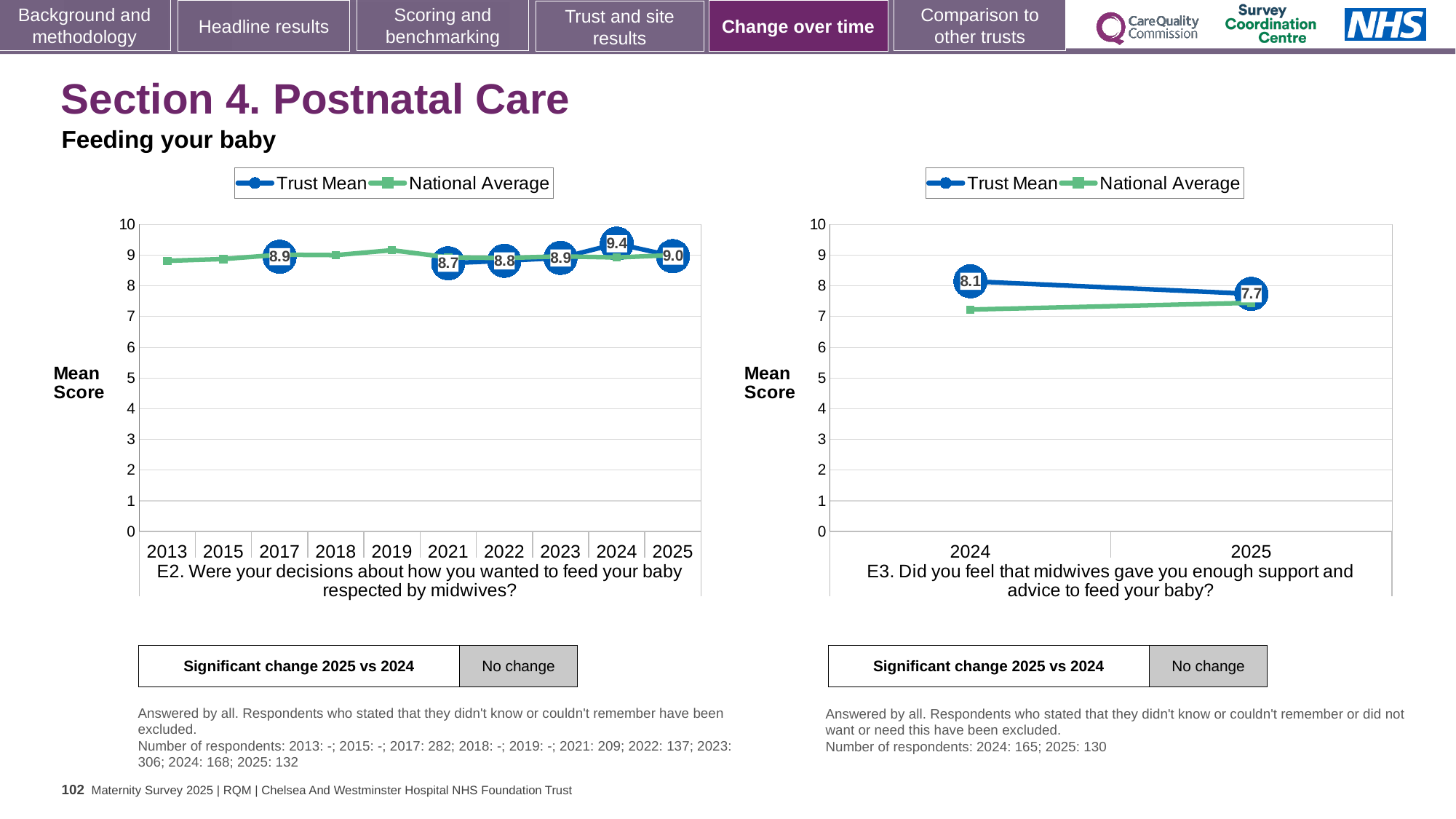
In the E2 chart on the left, what is the Trust Mean for 2021? 8.7 In the E2 chart on the left, how many series does the legend list? 2 In the E2 chart on the left, what is the difference between the Trust Mean for 2024 and 2025? 0.4 In the E3 chart on the right, does the Trust Mean rise or fall from 2024 to 2025? fall In the E2 chart on the left, which year has the lowest labelled Trust Mean? 2021 In the E2 chart on the left, which year has the highest Trust Mean? 2024 In the E2 chart on the left, what is the Trust Mean for 2025? 9.0 In the E3 chart on the right, what is the Trust Mean for 2024? 8.1 What kind of chart is the E3 chart on the right? line chart In the E3 chart on the right, is the National Average for 2024 greater or less than 8? less In the E3 chart on the right, what is the Trust Mean for 2025? 7.7 In the E2 chart on the left, what is the Trust Mean for 2024? 9.4